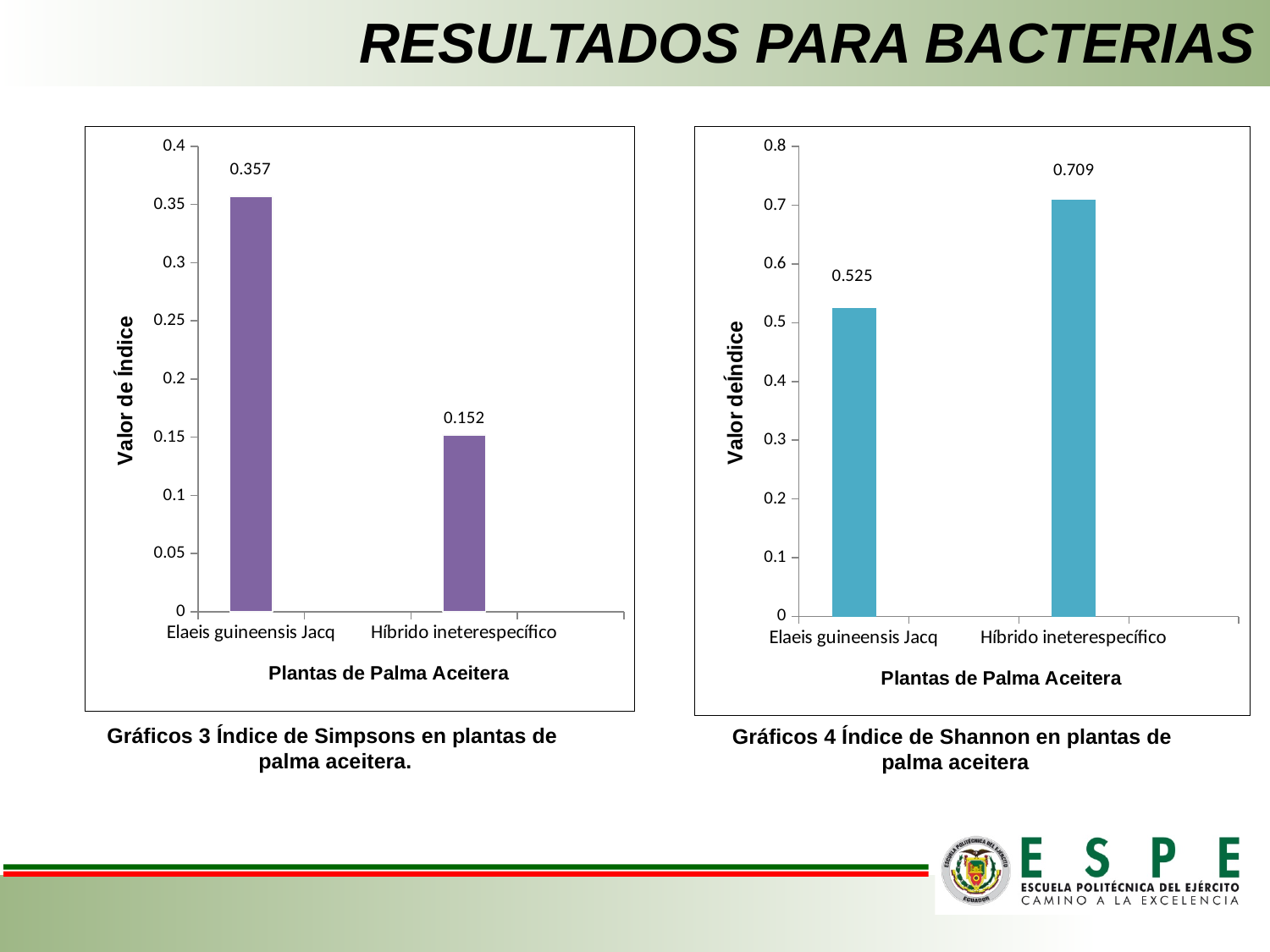
In the right chart (Índice de Shannon), what is the value for Elaeis guineensis Jacq? 0.525 In the left chart (Índice de Simpsons), is the value for Híbrido ineterespecífico greater or less than 0.2? less In the right chart (Índice de Shannon), what is the value for Híbrido ineterespecífico? 0.709 In the left chart (Índice de Simpsons), which category has the highest value? Elaeis guineensis Jacq In the left chart (Índice de Simpsons), what is the value for Híbrido ineterespecífico? 0.152 How many categories are shown on the x axis of the right chart (Índice de Shannon)? 2 What kind of chart is the left chart (Índice de Simpsons)? bar chart In the left chart (Índice de Simpsons), what is the difference between the values for Elaeis guineensis Jacq and Híbrido ineterespecífico? 0.205 In the right chart (Índice de Shannon), which is larger: the value for Híbrido ineterespecífico or for Elaeis guineensis Jacq? Híbrido ineterespecífico In the right chart (Índice de Shannon), which category has the lowest value? Elaeis guineensis Jacq In the right chart (Índice de Shannon), what is the difference between the values for Híbrido ineterespecífico and Elaeis guineensis Jacq? 0.184 In the left chart (Índice de Simpsons), what is the value for Elaeis guineensis Jacq? 0.357